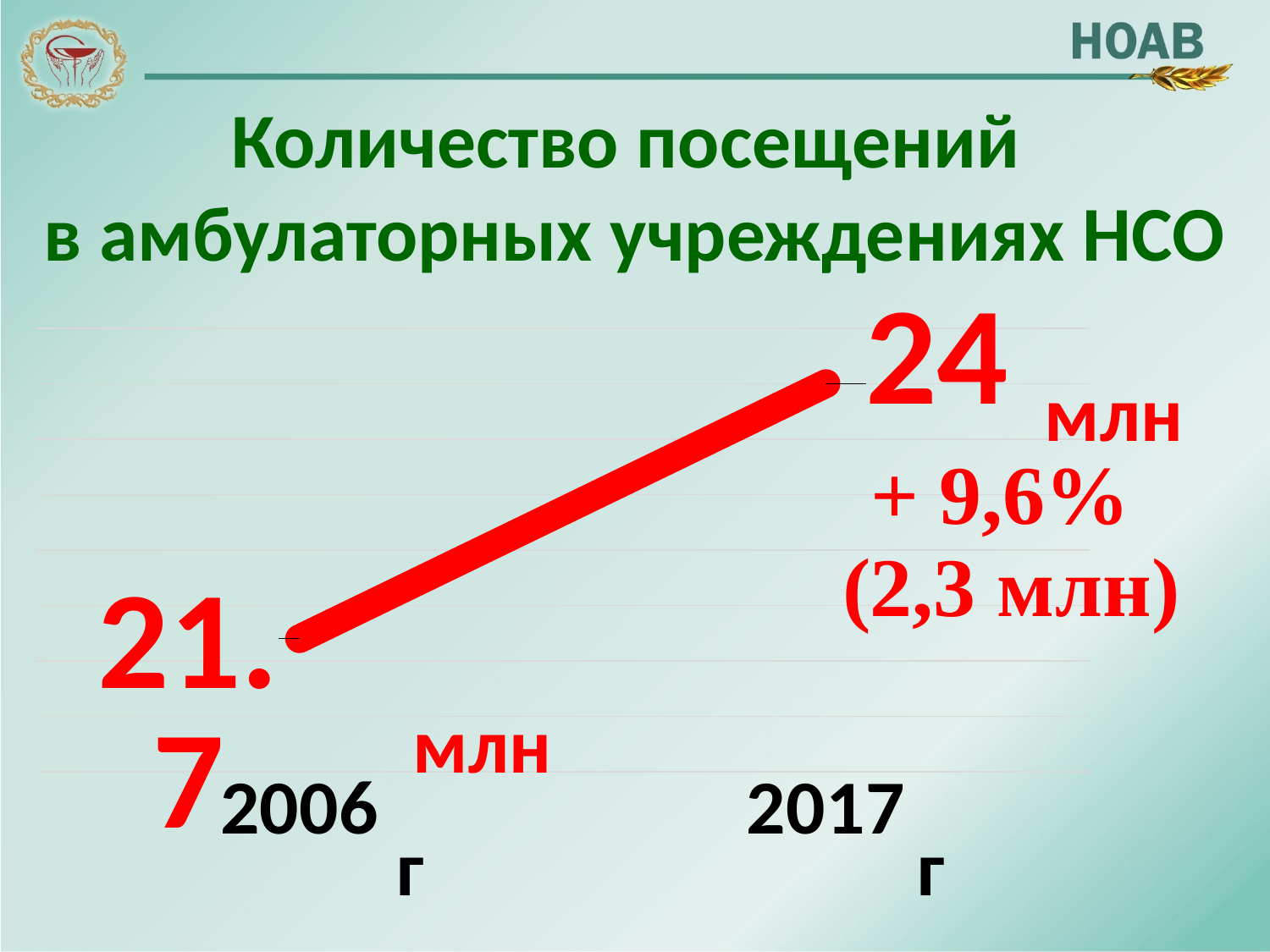
What is the value for 2006 г? 21.7 млн Which year has the highest value? 2017 г What is the title of the chart? Количество посещений в амбулаторных учреждениях НСО What is the difference between the values for 2017 г and 2006 г? 2,3 млн What percentage change is annotated on the chart between 2006 г and 2017 г? + 9,6% What kind of chart is shown on the slide? line chart How many data points are plotted on the chart? 2 Which year has the higher value, 2006 г or 2017 г? 2017 г Which year has the lowest value? 2006 г Do the values rise or fall from 2006 г to 2017 г? rise What is the value for 2017 г? 24 млн